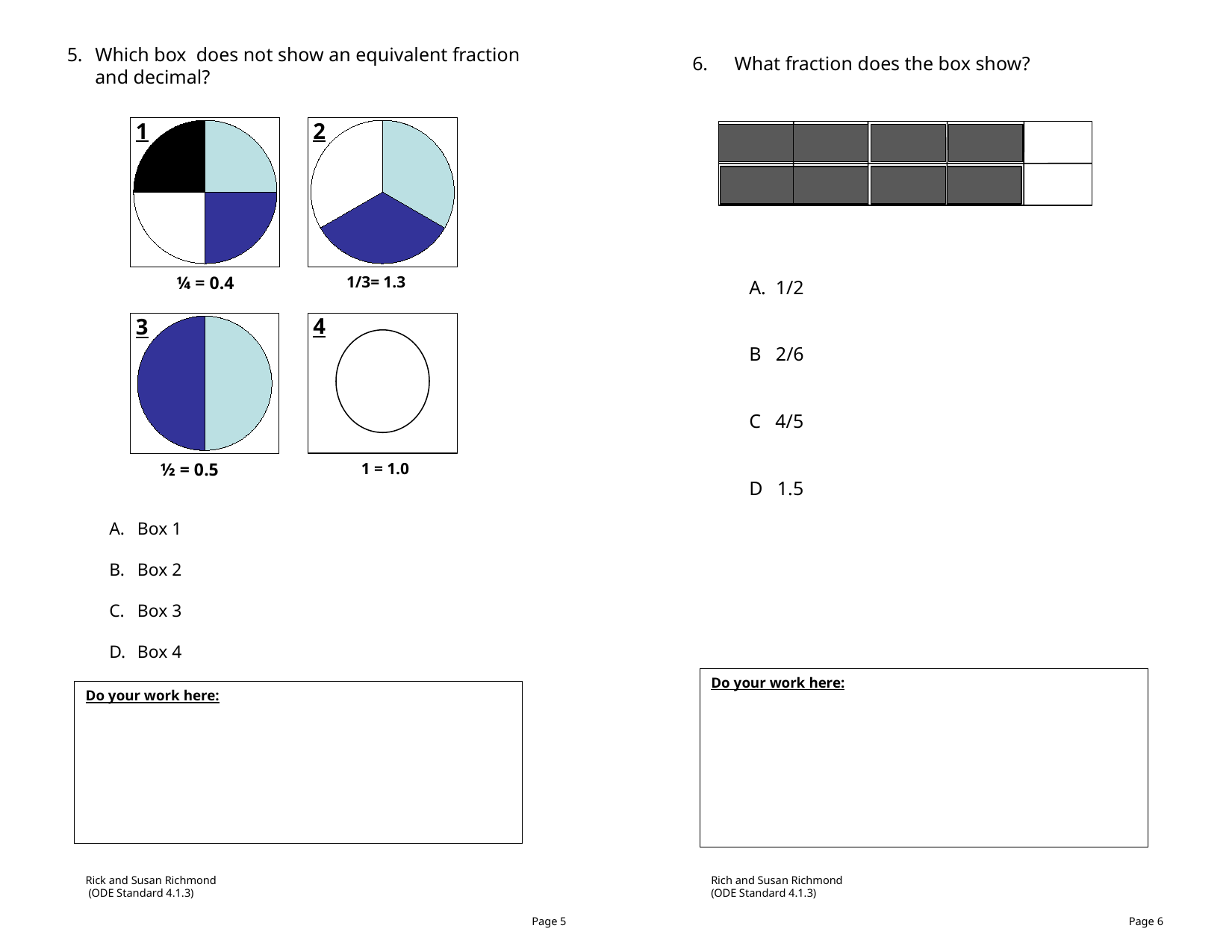
On the left page, what label is printed under Box 1? ¼ = 0.4 On the left page, what kind of diagram is used in Boxes 1 to 4 to show the fractions? Pie chart On the left page, what label is printed under Box 4? 1 = 1.0 On the right page, how many cells of the grid for question 6 are left unshaded? 2 On the left page, how many equal slices is the circle in Box 1 divided into? 4 On the left page, what label is printed under Box 3? ½ = 0.5 On the left page, how many equal slices is the circle in Box 2 divided into? 3 On the left page, what label is printed under Box 2? 1/3= 1.3